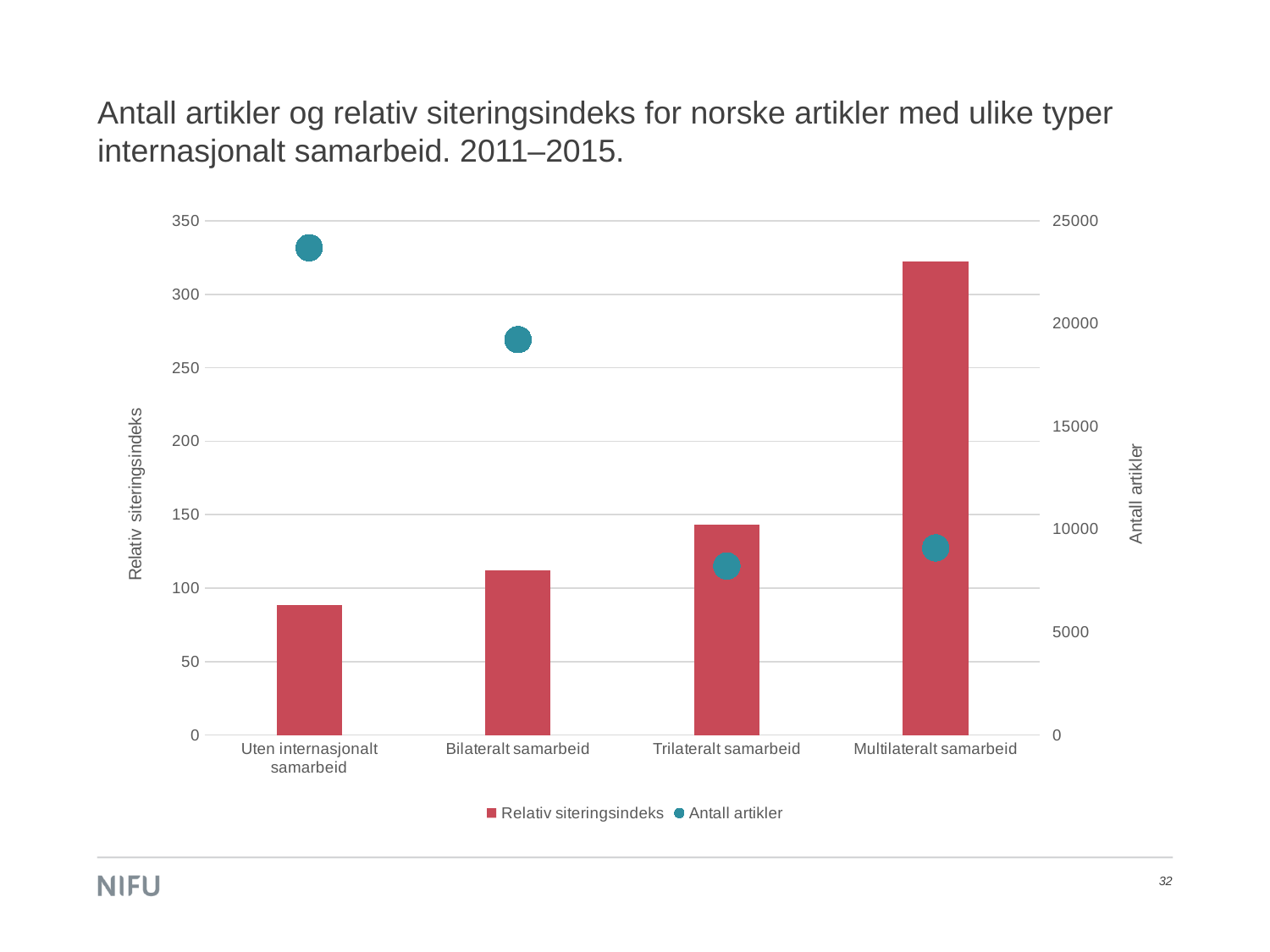
Which category has the lowest Relativ siteringsindeks? Uten internasjonalt samarbeid How many series does the legend list? 2 Does the Relativ siteringsindeks rise or fall from left to right across the categories? rise Is the Relativ siteringsindeks for Uten internasjonalt samarbeid greater or less than 100? less Is the Antall artikler for Trilateralt samarbeid greater or less than 10000? less Is the Relativ siteringsindeks for Multilateralt samarbeid greater or less than 300? greater Which category has the highest Relativ siteringsindeks? Multilateralt samarbeid What kind of chart is shown on the slide? A combined bar and scatter (dot) chart How many categories are shown on the x axis? 4 Which is larger, the Relativ siteringsindeks for Bilateralt samarbeid or for Trilateralt samarbeid? Trilateralt samarbeid Which category has the highest Antall artikler? Uten internasjonalt samarbeid